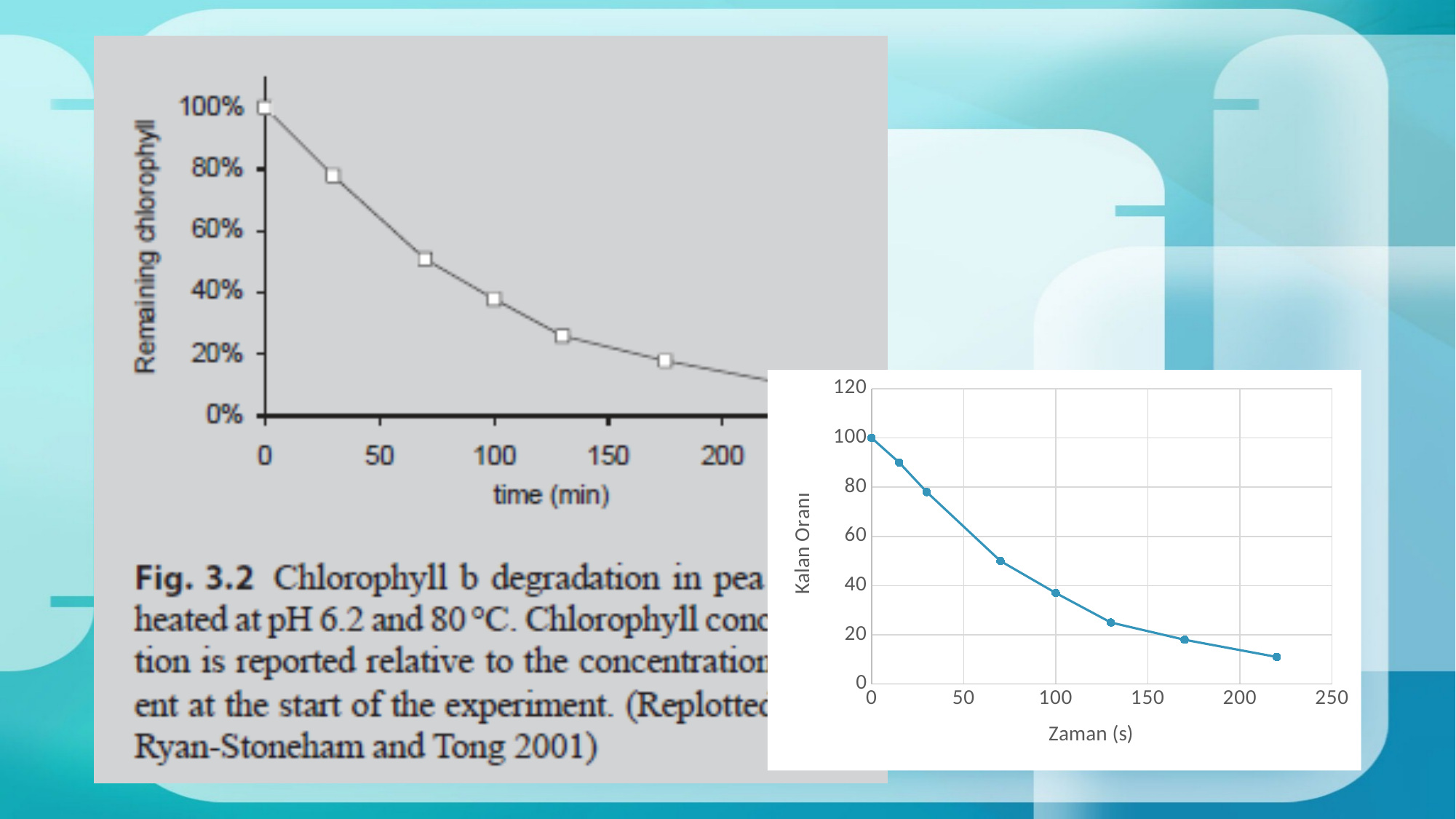
In the Fig. 3.2 chart on the left, what is the remaining chlorophyll at time 0? 100% In the Fig. 3.2 chart on the left, does remaining chlorophyll rise or fall as time increases? fall In the chart on the right, what is the label of the x axis? Zaman (s) In the chart on the right (Kalan Oranı vs Zaman), is the value at Zaman 30 greater or less than 60? greater In the chart on the right (Kalan Oranı vs Zaman), what is the Kalan Oranı value at Zaman 0? 100 In the chart on the right (Kalan Oranı vs Zaman), do the values rise or fall as Zaman increases? fall What kind of chart is the chart on the right with axes 'Kalan Oranı' and 'Zaman (s)'? line chart In the Fig. 3.2 chart on the left, is the remaining chlorophyll at 100 min greater or less than 40%? less In the chart on the right (Kalan Oranı vs Zaman), at which Zaman value is Kalan Oranı highest? 0 In the chart on the right (Kalan Oranı vs Zaman), is the value at Zaman 100 greater or less than 40? less In the chart on the right (Kalan Oranı vs Zaman), how many data points are plotted? 8